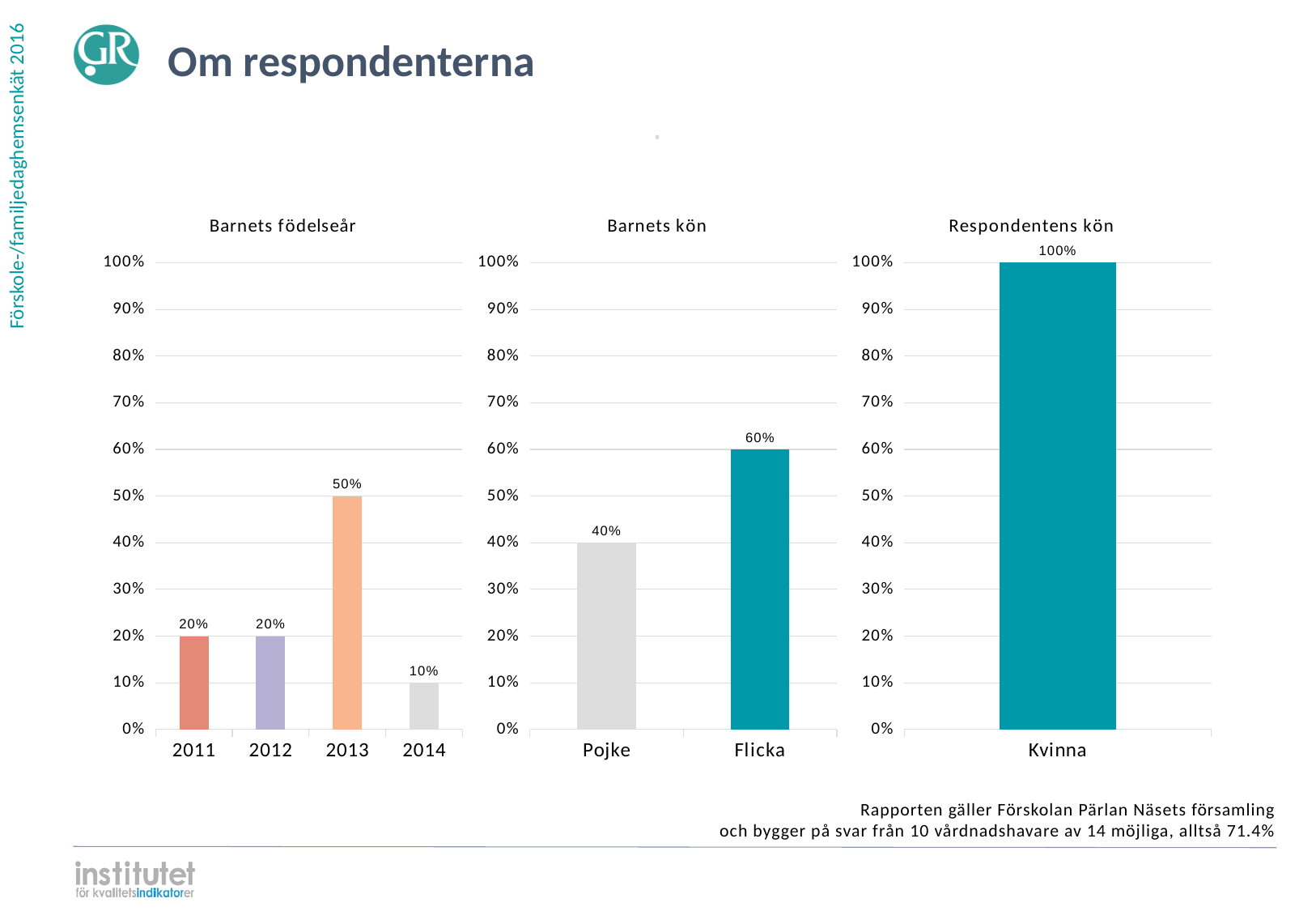
In the 'Barnets kön' chart, what is the difference between Flicka and Pojke? 20% In the 'Barnets födelseår' chart, what is the value for 2013? 50% In the 'Barnets födelseår' chart, what is the difference between the values for 2013 and 2014? 40% What kind of chart is the 'Barnets kön' chart? Bar chart In the 'Respondentens kön' chart, how many categories are shown? 1 In the 'Barnets födelseår' chart, which birth year has the lowest value? 2014 In the 'Barnets födelseår' chart, which birth year has the highest value? 2013 What is the title of the leftmost chart on the slide? Barnets födelseår In the 'Barnets födelseår' chart, how many birth years are shown on the x axis? 4 In the 'Barnets kön' chart, which is larger, Pojke or Flicka? Flicka In the 'Barnets kön' chart, what is the value for Pojke? 40% In the 'Respondentens kön' chart, what is the value for Kvinna? 100%